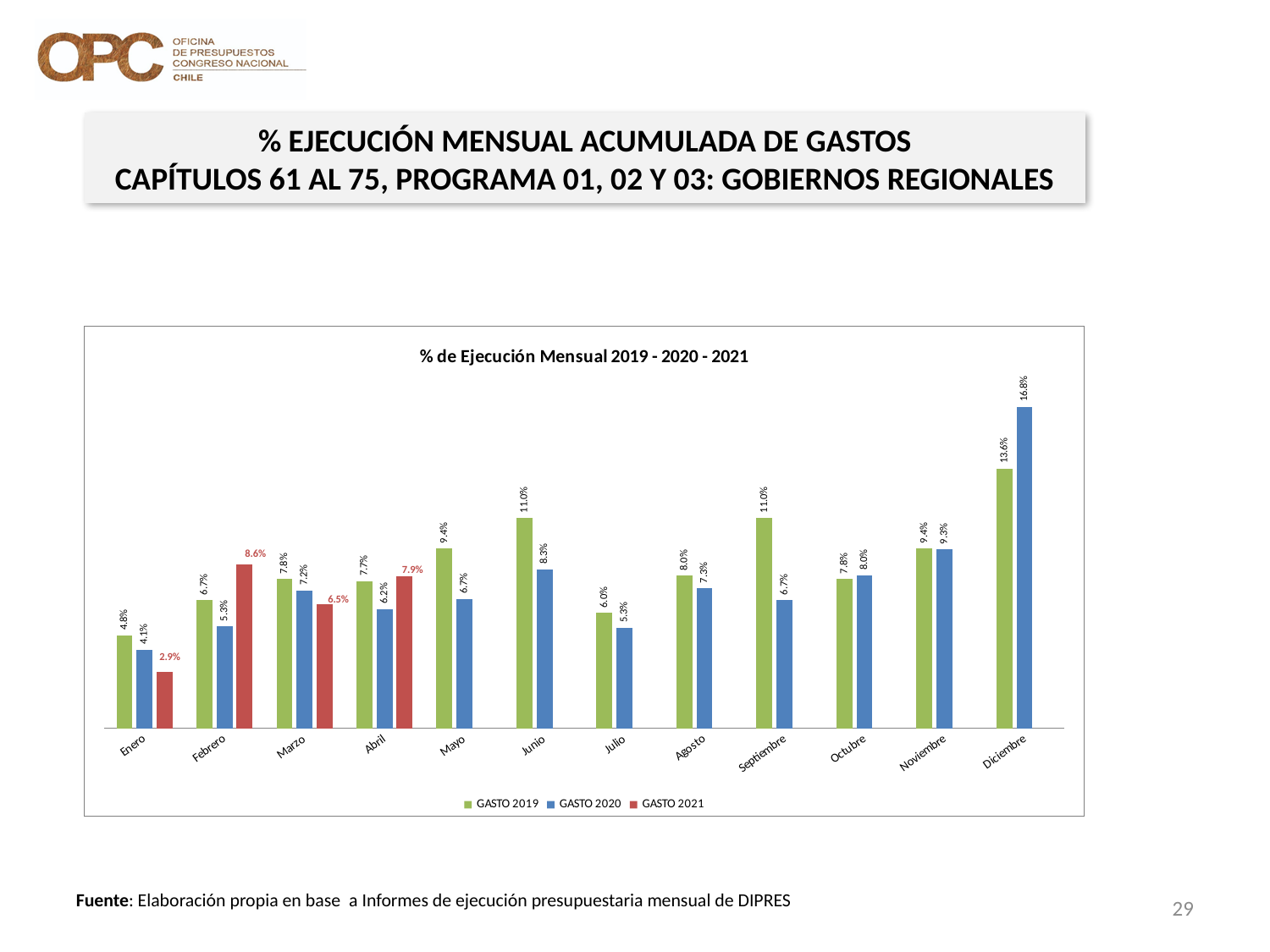
What is the GASTO 2020 value for Diciembre? 16.8% How many months are shown on the x axis? 12 How many series does the legend list? 3 What is the GASTO 2021 value for Enero? 2.9% What is the title of the chart? % de Ejecución Mensual 2019 - 2020 - 2021 Which month has the highest GASTO 2020 value? Diciembre What is the difference between the GASTO 2019 and GASTO 2020 values for Diciembre? 3.2% Which month has the lowest GASTO 2019 value? Enero Which month is the last one with a GASTO 2021 bar? Abril What kind of chart is shown on the slide? Bar chart Which is larger for Febrero: GASTO 2019 or GASTO 2021? GASTO 2021 What is the GASTO 2019 value for Septiembre? 11.0%